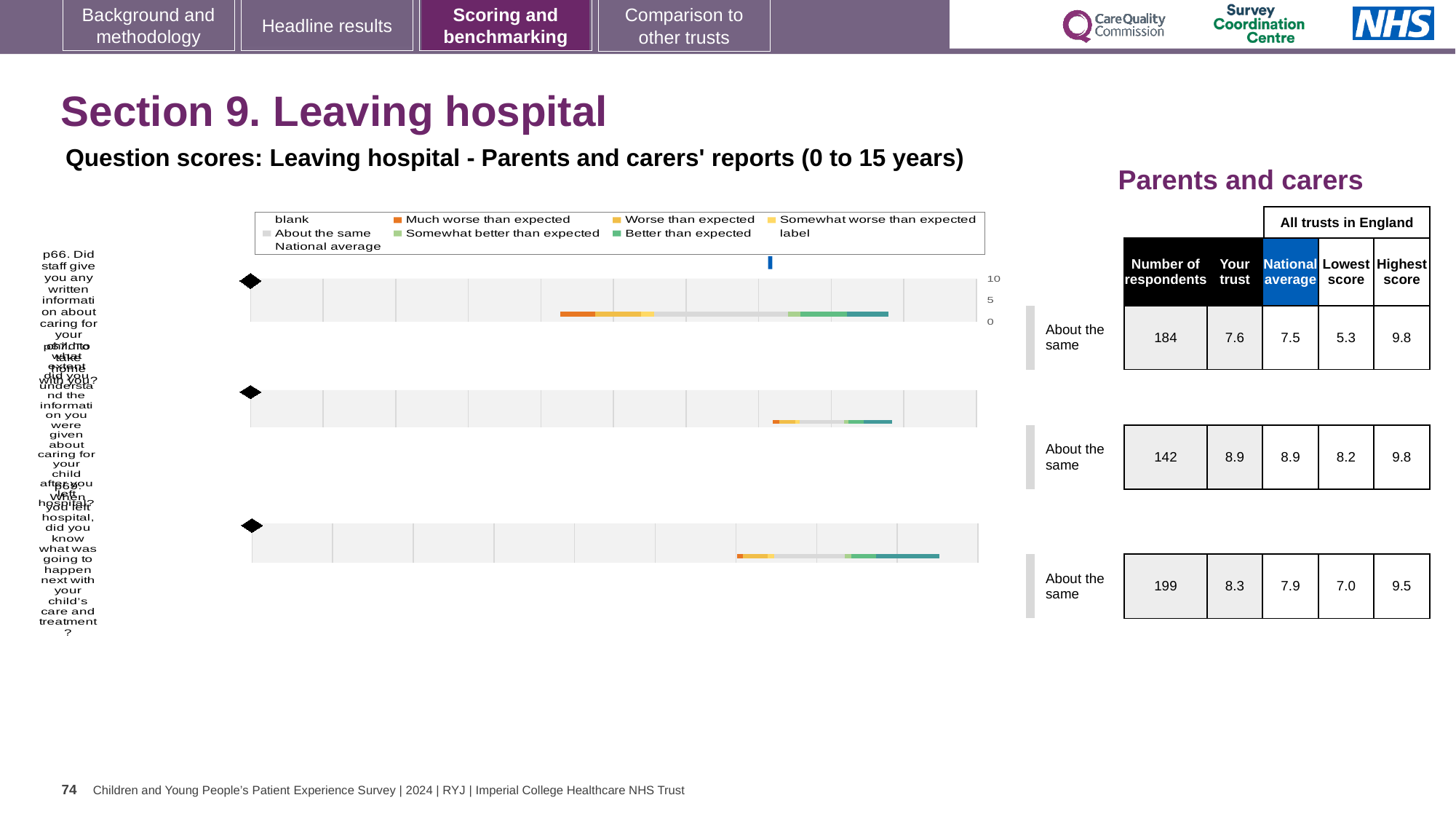
What benchmark category is shown for all three charts? About the same For the first chart (p66), what is the difference between the highest score and the lowest score across all trusts in England? 4.5 Which of the three charts has the highest 'Your trust' score? the second chart (p67) For the second chart (p67), what is the 'Your trust' score? 8.9 For the first chart (p66), what is the national average score? 7.5 For the third chart (p68), what is the difference between the 'Your trust' score and the national average? 0.4 For the third chart (p68), which is larger: the 'Your trust' score or the national average? Your trust For the first chart (p66, written information about caring for your child at home), what is the 'Your trust' score? 7.6 How many question charts are shown on the slide? 3 For the third chart (p68, did you know what was going to happen next), what is the highest score among all trusts in England? 9.5 For the first chart (p66), how many respondents are there? 184 What kind of chart is used to show the question scores on this slide? bar chart